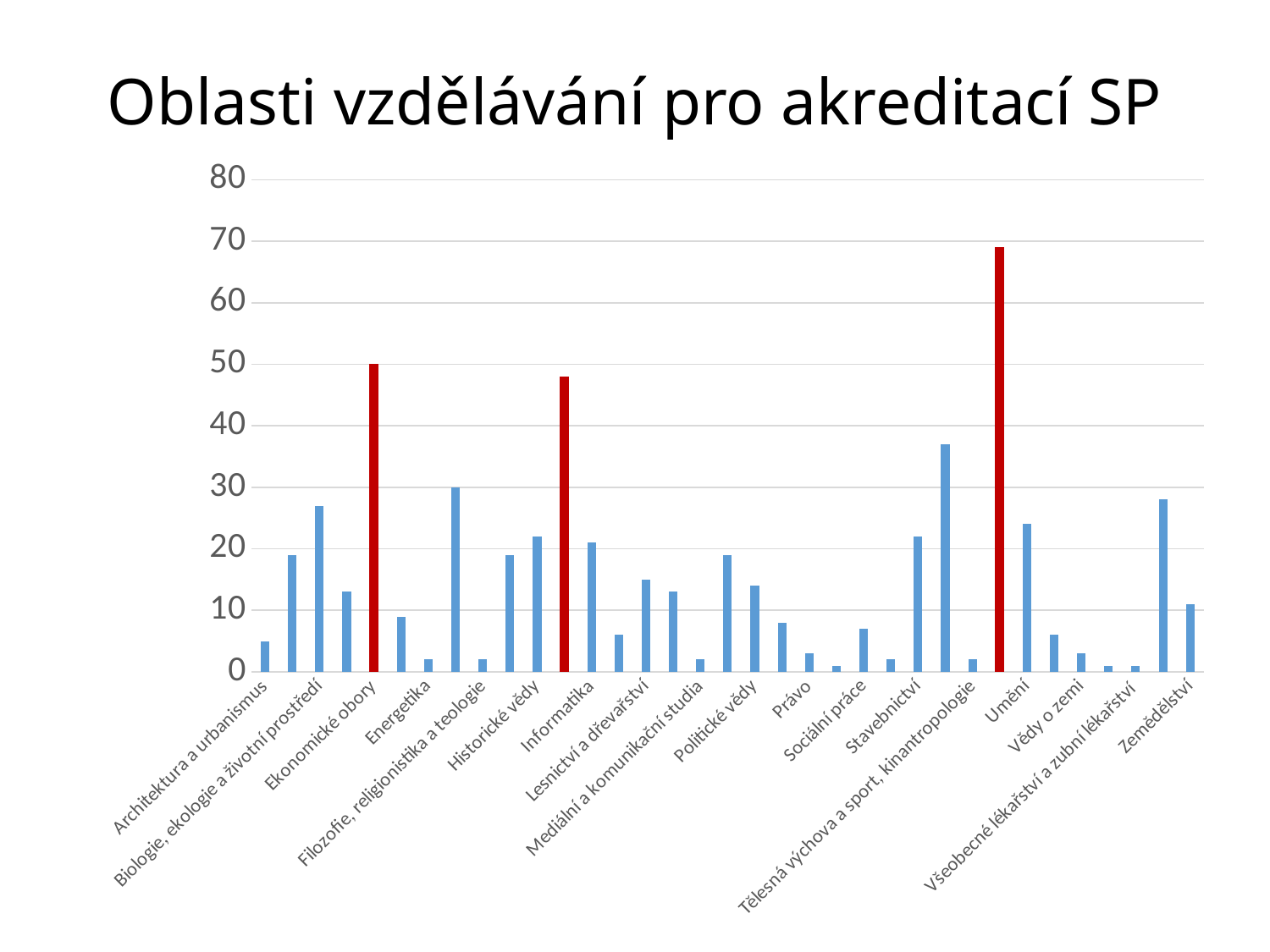
What is the title of the chart? Oblasti vzdělávání pro akreditací SP What kind of chart is shown on the slide? bar chart Is the value for Ekonomické obory greater or less than 40? greater How many bars are coloured red in the chart? 3 Is the value for Architektura a urbanismus greater or less than 10? less Is the value for Biologie, ekologie a životní prostředí greater or less than 20? greater Which has the larger value, Ekonomické obory or Umění? Ekonomické obory Which has the larger value, Biologie, ekologie a životní prostředí or Architektura a urbanismus? Biologie, ekologie a životní prostředí